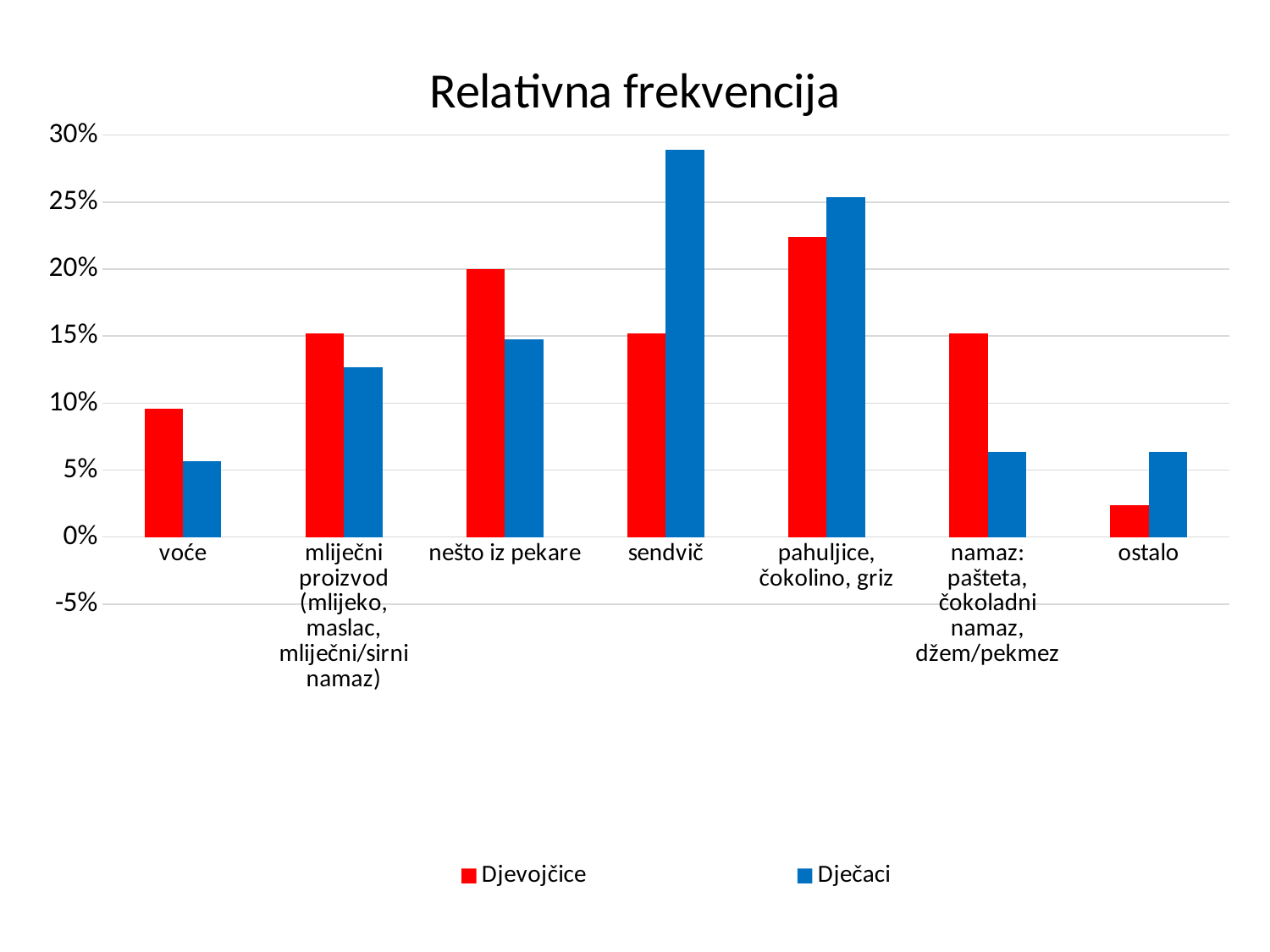
Which category has the lowest value for Dječaci? voće What is the title of the chart? Relativna frekvencija How many series does the legend list? 2 Which category has the lowest value for Djevojčice? ostalo Which colour represents the Djevojčice series? red For sendvič, which series has the larger value, Djevojčice or Dječaci? Dječaci Which category has the highest value for Djevojčice? pahuljice, čokolino, griz For voće, which series has the larger value, Djevojčice or Dječaci? Djevojčice Which category has the highest value for Dječaci? sendvič What kind of chart is shown on the slide? bar chart How many categories are shown on the x axis? 7 Is the value for Dječaci in the sendvič category greater or less than 25%? greater